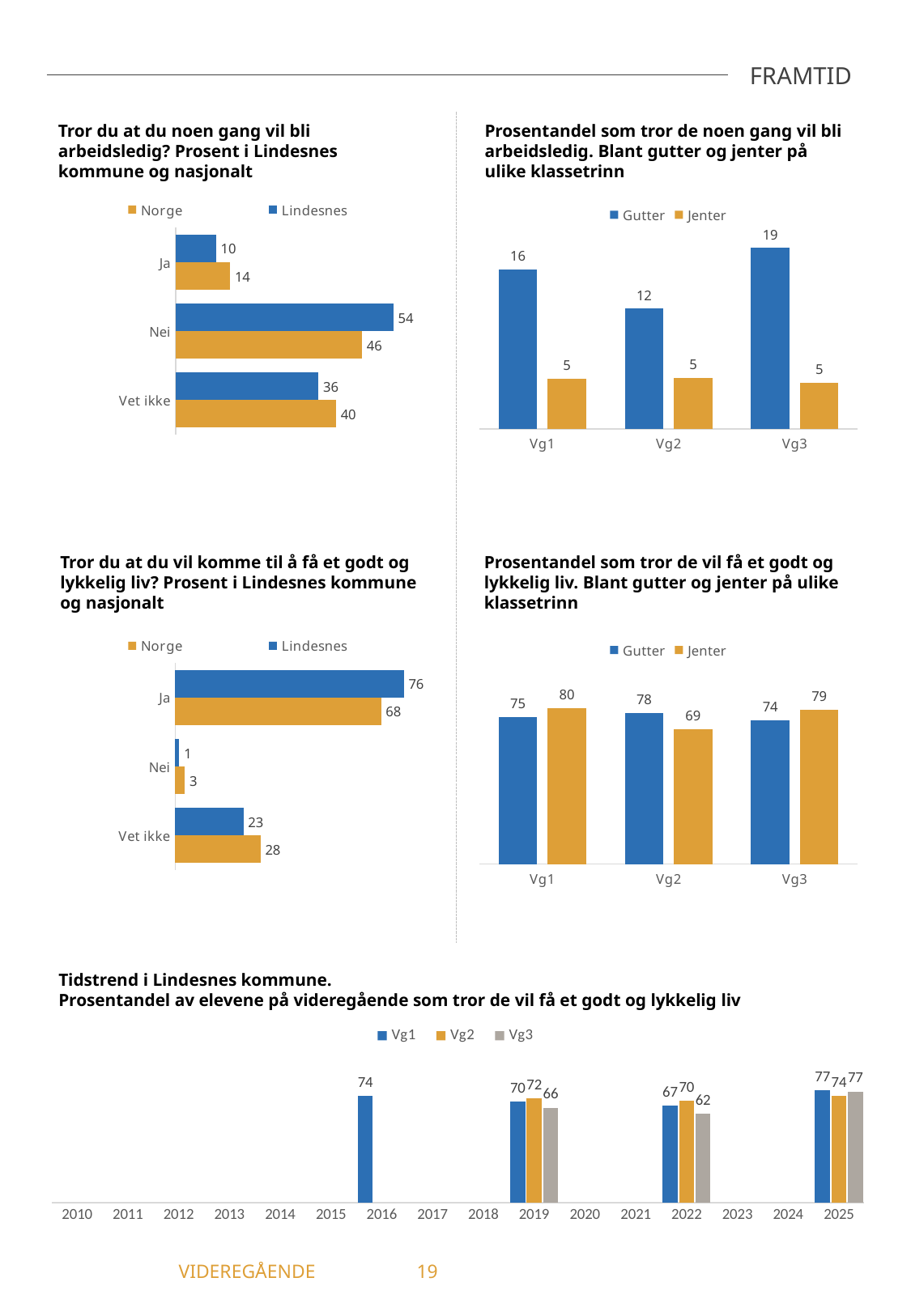
In the top-right chart 'Prosentandel som tror de noen gang vil bli arbeidsledig', which klassetrinn has the highest value for Gutter? Vg3 In the middle-left chart 'Tror du at du vil komme til å få et godt og lykkelig liv?', what is the value for Norge for 'Nei'? 3 In the middle-right chart 'Prosentandel som tror de vil få et godt og lykkelig liv', what is the value for Jenter at Vg1? 80 In the bottom chart 'Tidstrend i Lindesnes kommune', what is the difference between the Vg1 values in 2025 and 2022? 10 In the middle-left chart 'Tror du at du vil komme til å få et godt og lykkelig liv?', which is larger for 'Ja': Norge or Lindesnes? Lindesnes What kind of chart is the top-left chart 'Tror du at du noen gang vil bli arbeidsledig?'? Bar chart In the bottom chart 'Tidstrend i Lindesnes kommune', what is the value for Vg3 in 2022? 62 How many series does the legend of the bottom chart 'Tidstrend i Lindesnes kommune' list? 3 In the top-left chart 'Tror du at du noen gang vil bli arbeidsledig?', what is the value for Lindesnes for 'Nei'? 54 In the top-left chart 'Tror du at du noen gang vil bli arbeidsledig?', what is the difference between the Norge and Lindesnes values for 'Vet ikke'? 4 In the top-right chart 'Prosentandel som tror de noen gang vil bli arbeidsledig', what is the value for Jenter at Vg2? 5 In the middle-right chart 'Prosentandel som tror de vil få et godt og lykkelig liv', which klassetrinn has the lowest value for Jenter? Vg2